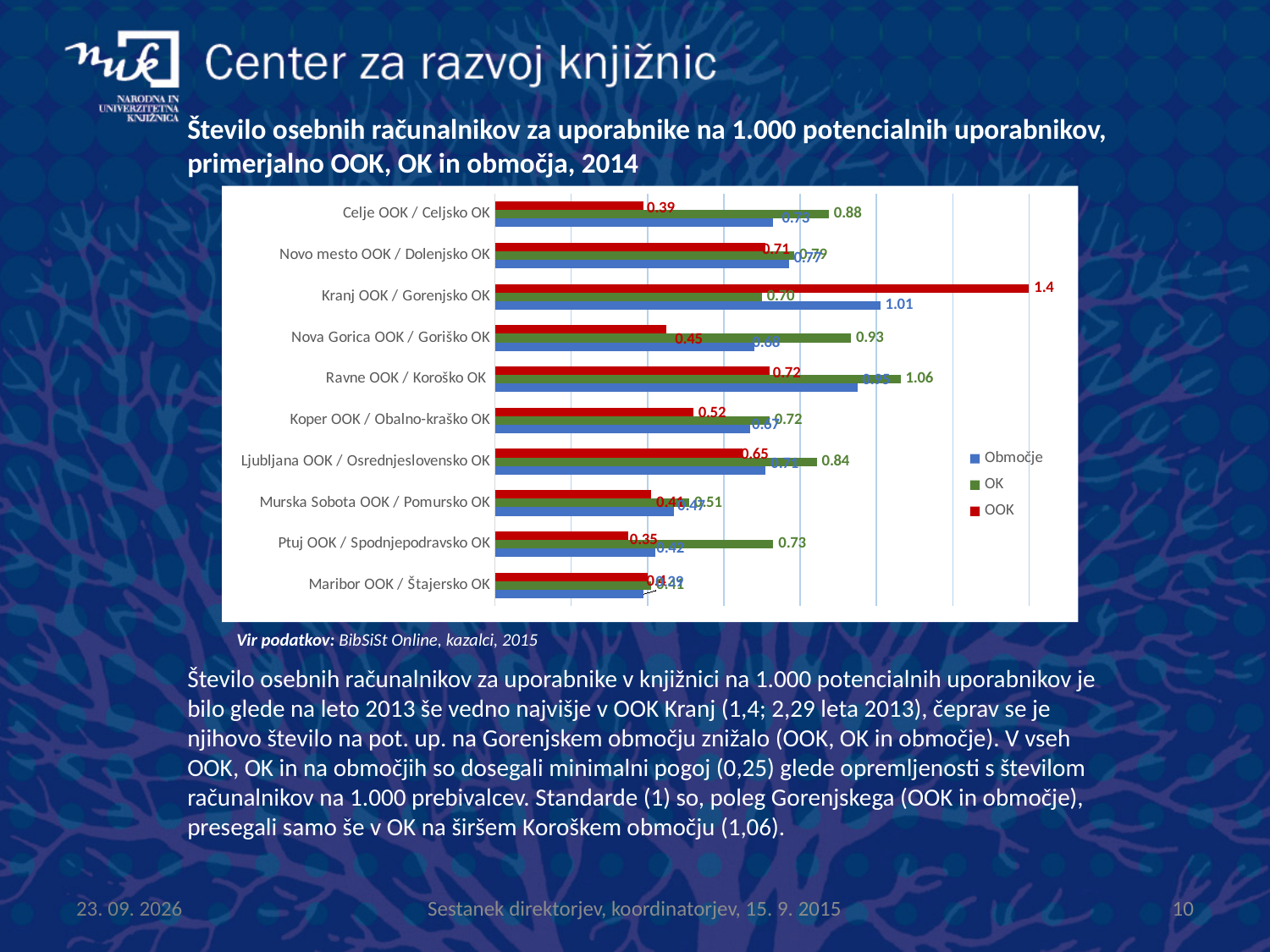
Which category has the highest OOK value? Kranj OOK / Gorenjsko OK How many categories (library pairs) are shown on the chart? 10 What is the OOK value for Kranj OOK / Gorenjsko OK? 1.4 What is the Območje value for Kranj OOK / Gorenjsko OK? 1.01 How many series does the chart legend list? 3 Which category has the lowest OOK value? Ptuj OOK / Spodnjepodravsko OK What kind of chart is shown on the slide? bar chart Which category has the highest OK value? Ravne OOK / Koroško OK For Nova Gorica OOK / Goriško OK, which is larger: the OK value or the OOK value? OK For Celje OOK / Celjsko OK, what is the difference between the OK value and the OOK value? 0.49 What is the OK value for Ravne OOK / Koroško OK? 1.06 What is the OK value for Ljubljana OOK / Osrednjeslovensko OK? 0.84